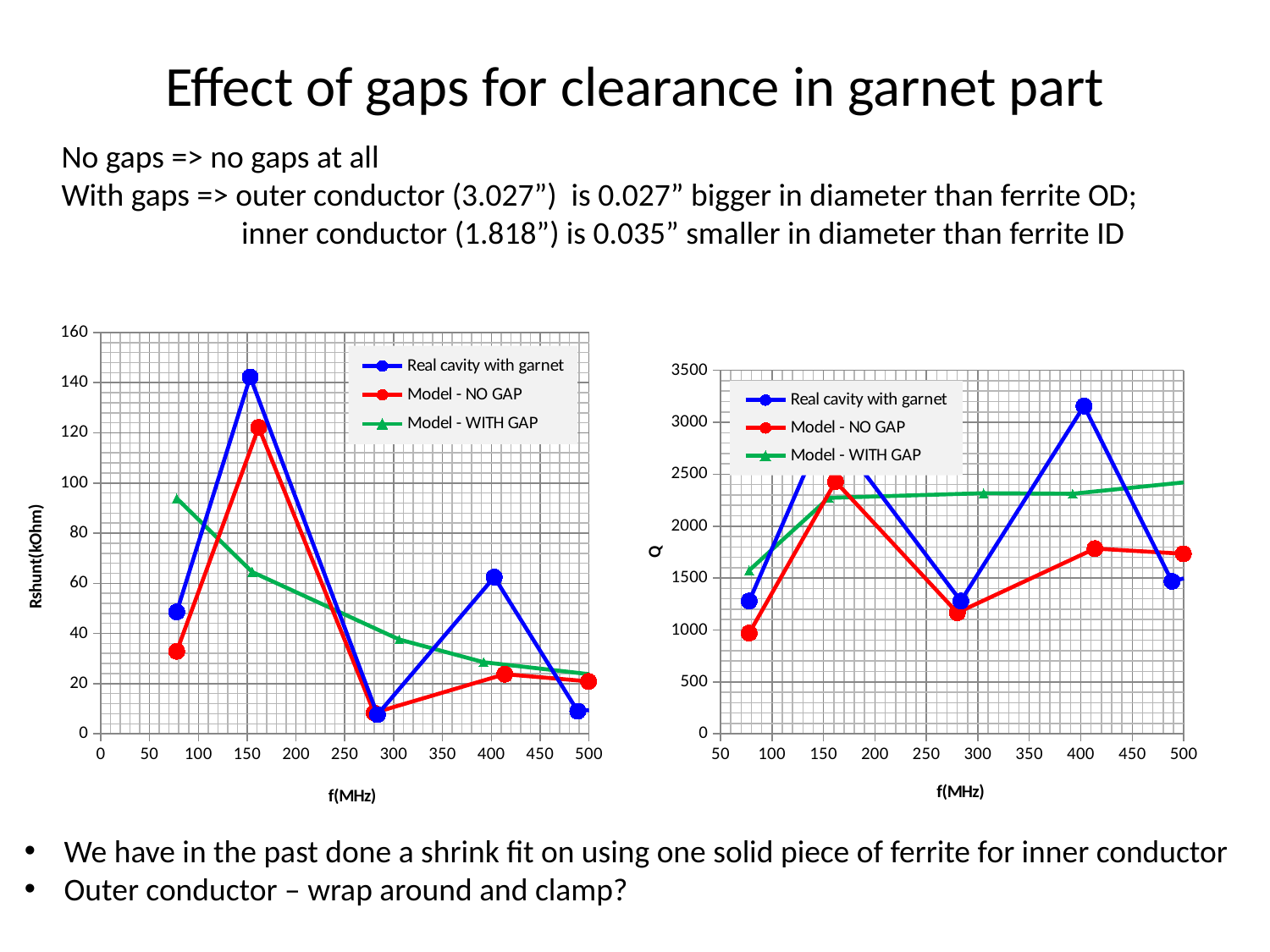
How many data points does the Real cavity with garnet series have in the left chart? 5 In the left chart, which series reaches the highest Rshunt value? Real cavity with garnet How many series does the legend of the left chart list? 3 In the left chart, is the peak value of the Model - NO GAP series greater or less than 100? greater In the left chart, does the Model - WITH GAP series rise or fall as frequency increases? fall In the left chart, is the peak value of the Real cavity with garnet series greater or less than 120? greater What are the three series named in the legend of the right chart (Q vs f(MHz))? Real cavity with garnet, Model - NO GAP, Model - WITH GAP In the right chart, does the Model - WITH GAP series rise or fall as frequency increases? rise In the right chart, is the Real cavity with garnet value near 400 MHz greater or less than 3000? greater What kind of chart is the left chart (Rshunt vs f(MHz))? line chart In the right chart, near 400 MHz, which is larger: Real cavity with garnet or Model - NO GAP? Real cavity with garnet